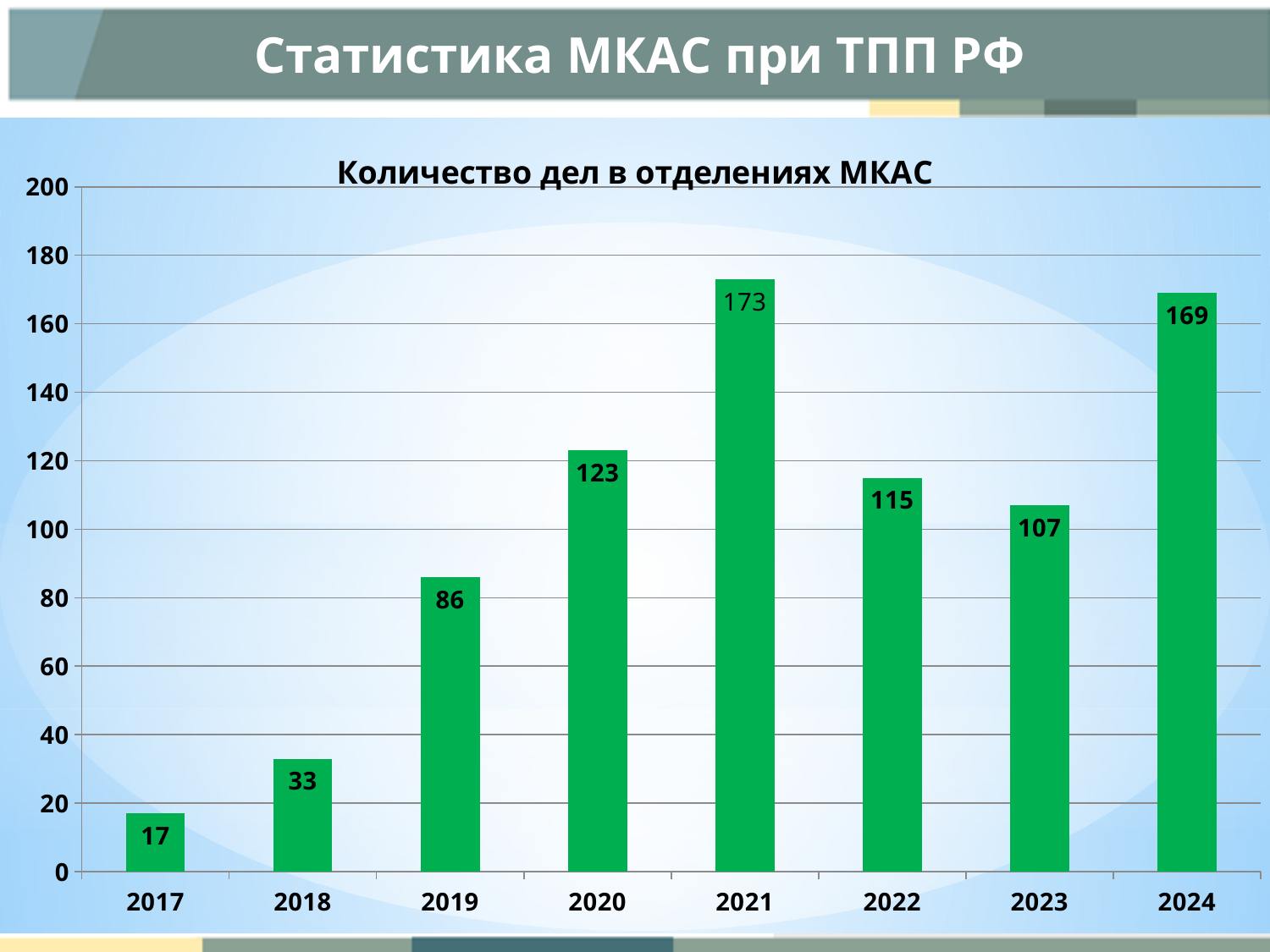
Which is larger, the value for 2022 or the value for 2023? 2022 How many years are shown on the x axis? 8 What is the value for 2024? 169 Is the value for 2020 greater or less than 100? greater What is the title of the chart? Количество дел в отделениях МКАС Which year has the highest value? 2021 What kind of chart is this? bar chart Which year has the lowest value? 2017 What is the value for 2019? 86 What is the value for 2021? 173 What is the difference between the values for 2020 and 2019? 37 What is the difference between the values for 2021 and 2024? 4